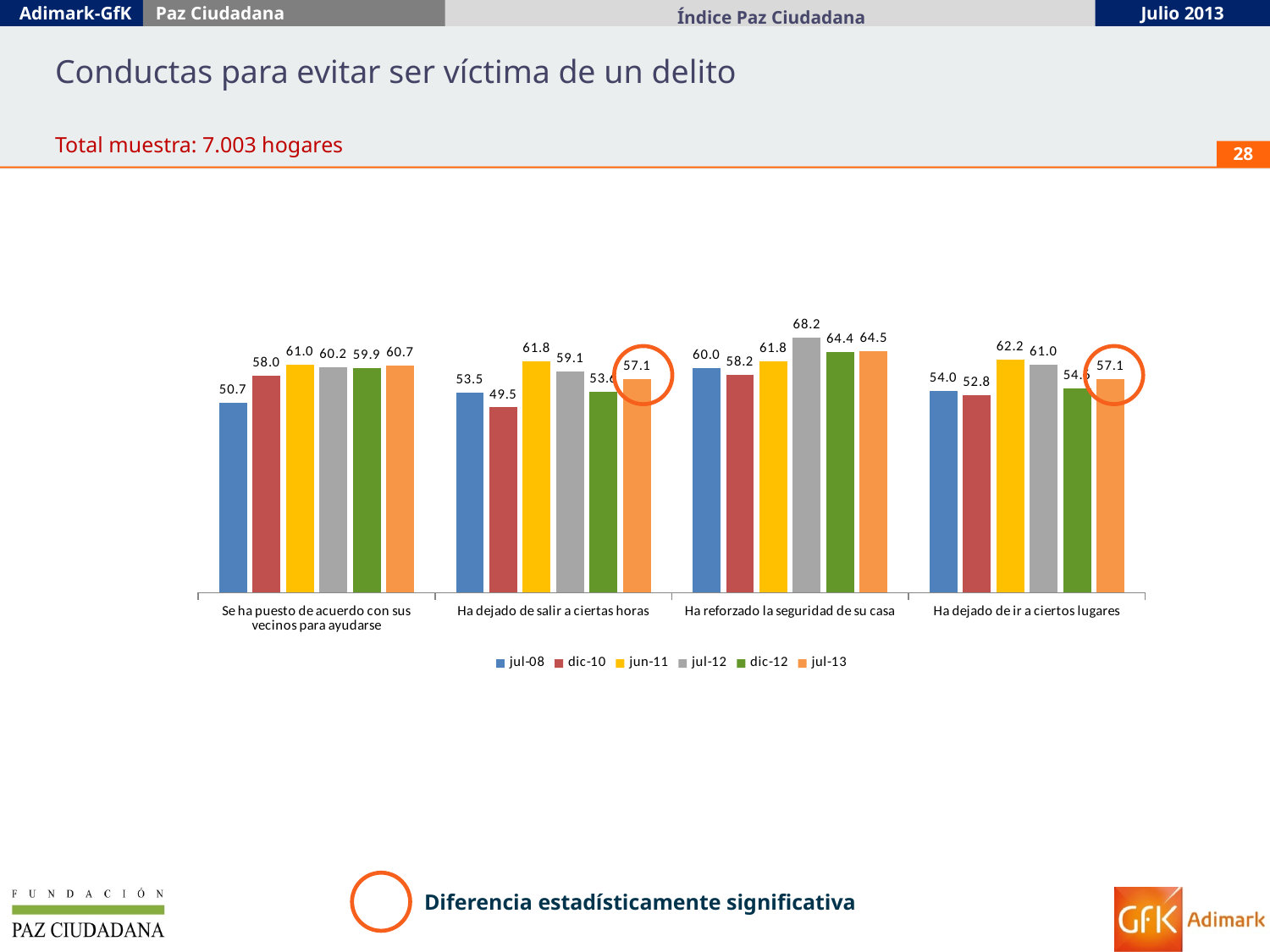
What kind of chart is shown on the slide? bar chart Which series has the lowest value for "Ha dejado de salir a ciertas horas"? dic-10 What is the jul-08 value for "Se ha puesto de acuerdo con sus vecinos para ayudarse"? 50.7 Which series has the highest value for "Ha reforzado la seguridad de su casa"? jul-12 What is the jun-11 value for "Ha dejado de ir a ciertos lugares"? 62.2 What is the jul-13 value for "Ha reforzado la seguridad de su casa"? 64.5 Which series is shown in orange in the legend? jul-13 What is the difference between the jul-12 and jul-08 values for "Ha reforzado la seguridad de su casa"? 8.2 Which is larger for "Se ha puesto de acuerdo con sus vecinos para ayudarse": the jul-08 value or the dic-10 value? dic-10 How many series does the legend list? 6 How many categories are shown on the x axis? 4 What is the dic-10 value for "Ha dejado de salir a ciertas horas"? 49.5